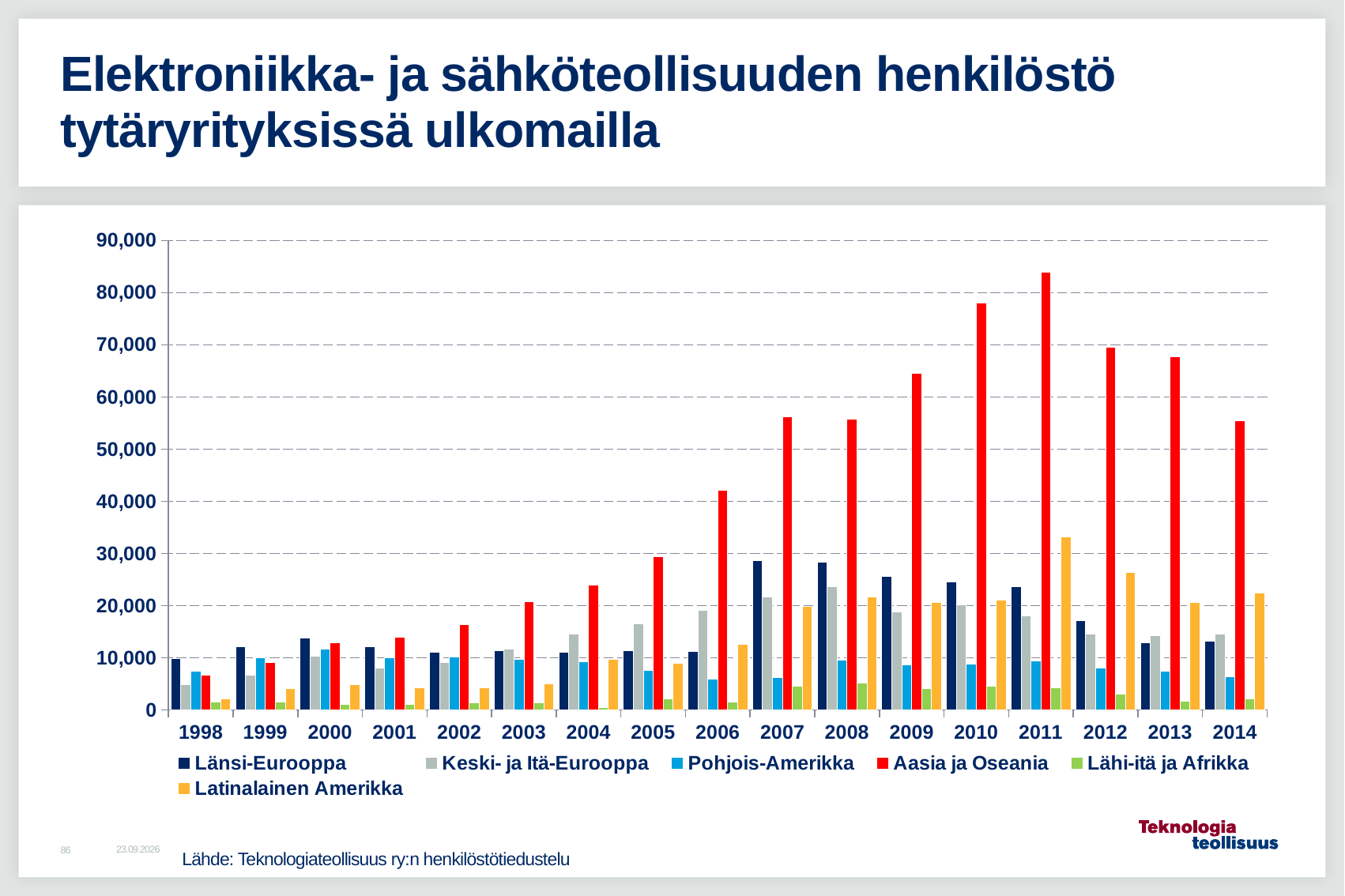
Is the value for Aasia ja Oseania in 1998 greater or less than 10,000? less Is the value for Aasia ja Oseania in 2010 greater or less than 70,000? greater In 2014, which is larger: Aasia ja Oseania or Länsi-Eurooppa? Aasia ja Oseania How many series does the legend list? 6 What kind of chart is shown on the slide? bar chart How many years are shown on the x axis? 17 Which series has the lowest value in 2014? Lähi-itä ja Afrikka Is the value for Latinalainen Amerikka in 2011 greater or less than 30,000? greater In 2012, which is larger: Latinalainen Amerikka or Länsi-Eurooppa? Latinalainen Amerikka In which year is the value for Aasia ja Oseania highest? 2011 Does the value for Aasia ja Oseania rise or fall from 1998 to 2011? rise